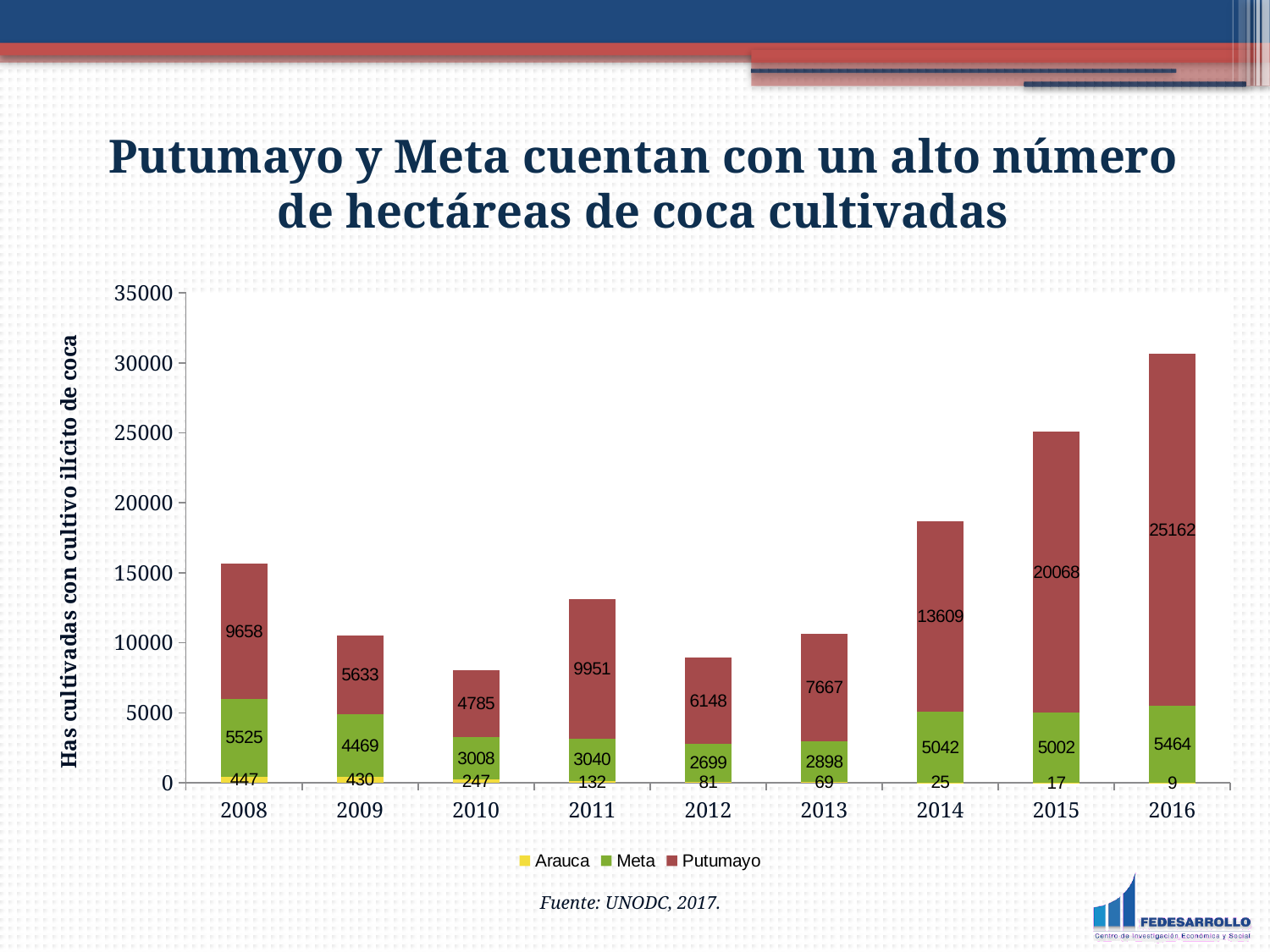
How many years are shown on the x axis? 9 How many series does the legend list? 3 Which is larger, the Meta value for 2008 or the Meta value for 2016? 2008 In which year is the Meta value lowest? 2012 What is the total of the stacked bar for 2016? 30635 In which year is the Putumayo value lowest? 2010 What is the Arauca value for 2008? 447 Is the total height of the 2014 stacked bar greater or less than 20000? less What is the difference between the Putumayo values for 2016 and 2015? 5094 In which year is the Putumayo value highest? 2016 What is the Meta value for 2009? 4469 What is the Putumayo value for 2016? 25162